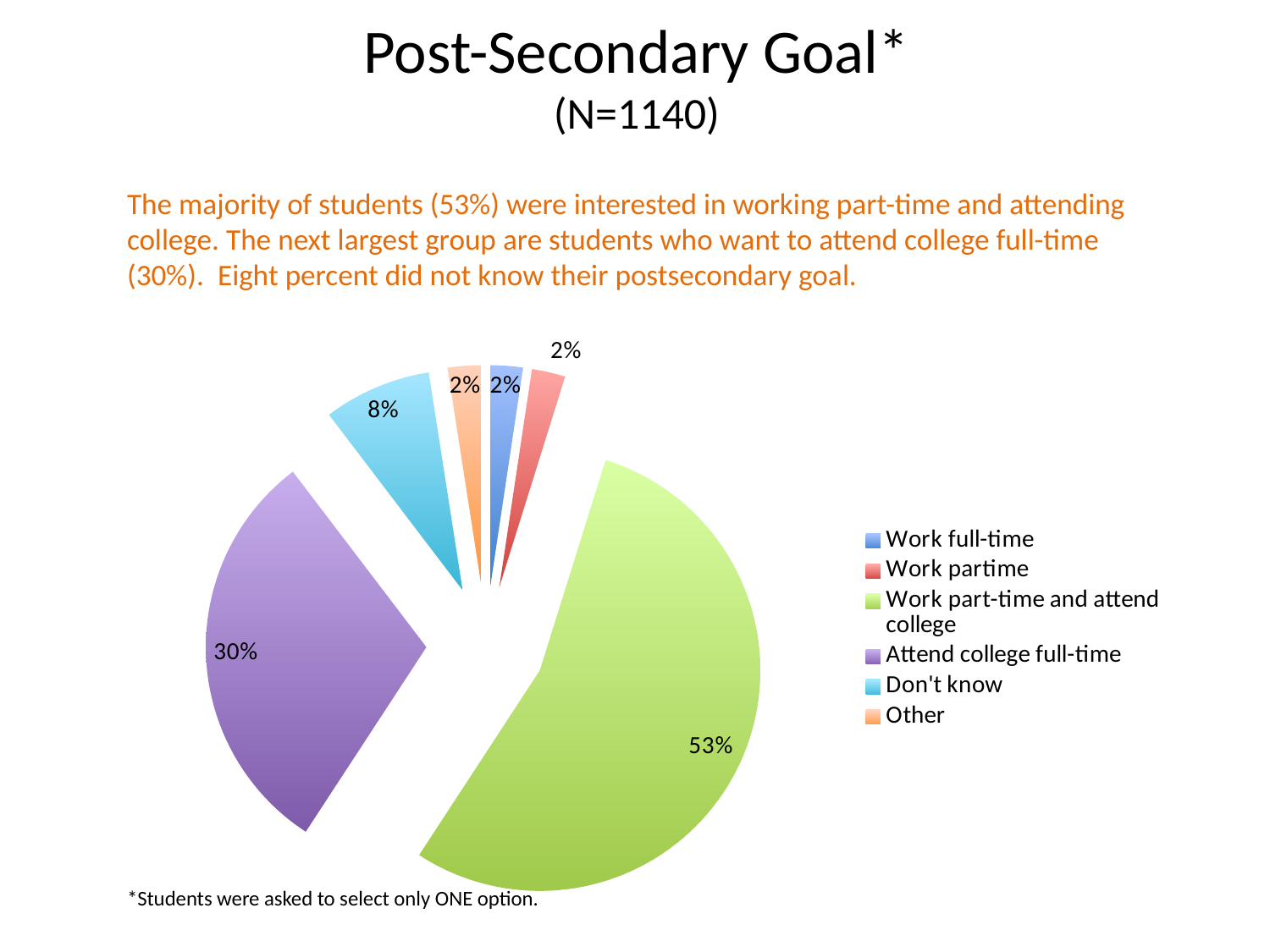
What percentage of students chose 'Attend college full-time'? 30% How many categories does the legend list? 6 Which category has the largest share of the pie? Work part-time and attend college What colour is the slice for 'Attend college full-time'? purple What is the title of the chart? Post-Secondary Goal* (N=1140) What percentage of students chose 'Work part-time and attend college'? 53% What percentage of students chose 'Work full-time'? 2% What percentage of students chose 'Other'? 2% What is the difference in percentage points between 'Work part-time and attend college' and 'Attend college full-time'? 23 What type of chart is shown on the slide? pie chart Which is larger: the share for 'Don't know' or the share for 'Attend college full-time'? Attend college full-time What percentage of students answered 'Don't know'? 8%